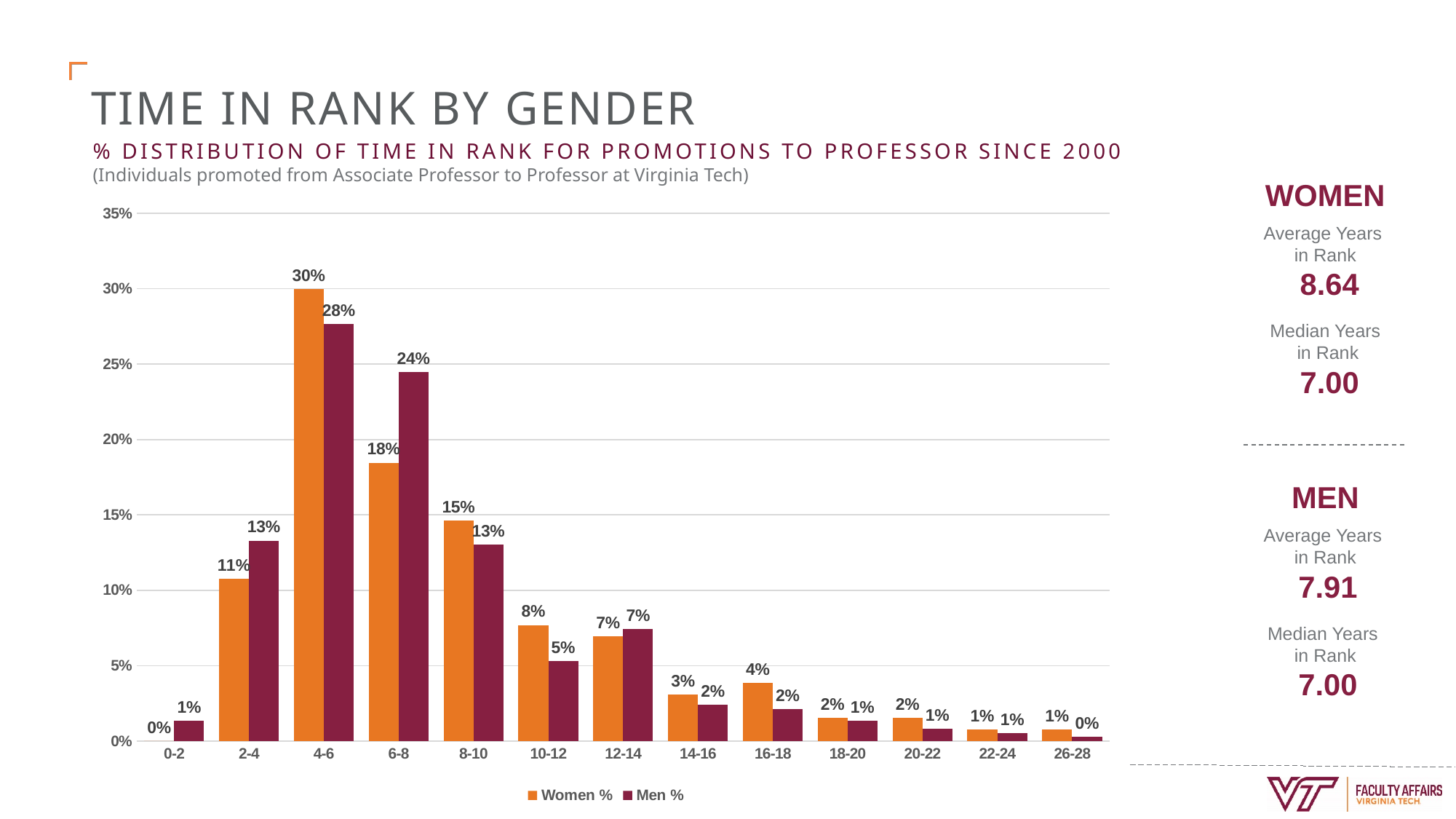
Which time-in-rank category has the highest Men % value? 4-6 In the 8-10 years category, which series has the larger value, Women % or Men %? Women % How many series does the legend list? 2 Which time-in-rank category has the highest Women % value? 4-6 What is the Men % value for the 6-8 years category? 24% How many time-in-rank categories are shown on the x axis? 13 From the 4-6 category to the 26-28 category, do the Men % values generally rise or fall? fall What is the Women % value for the 4-6 years category? 30% What is the Men % value for the 0-2 years category? 1% What kind of chart is shown on the slide? bar chart In the 6-8 years category, how much higher is the Men % value than the Women % value? 6% Is the Women % value for the 2-4 years category greater or less than 10%? greater